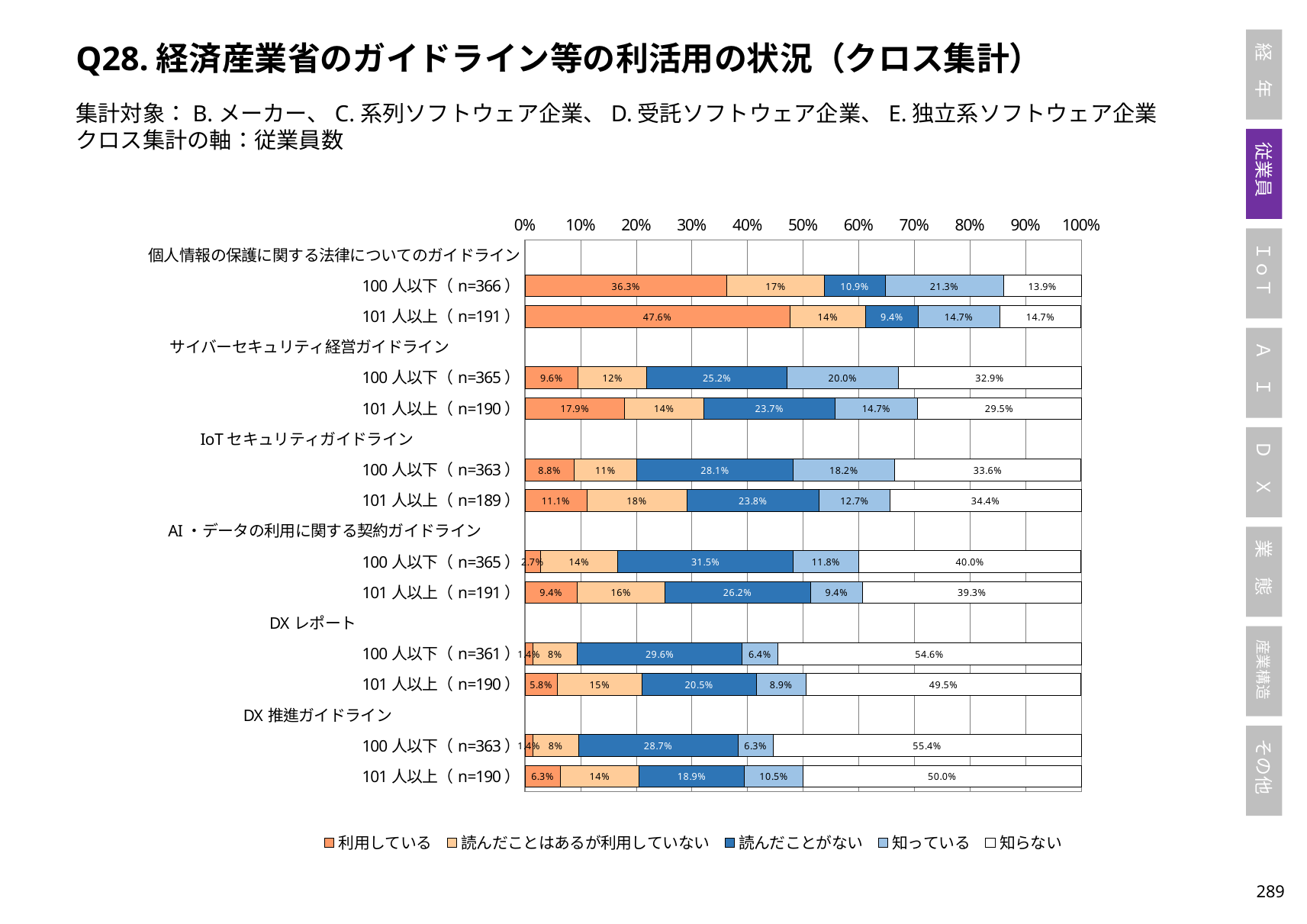
How many series does the chart legend list? 5 In the chart, what is the 読んだことがない value for 101人以上 (n=190) under DXレポート? 20.5% In the chart, what is the 利用している value for 101人以上 (n=191) under 個人情報の保護に関する法律についてのガイドライン? 47.6% What is the first entry in the chart legend? 利用している In the chart, what is the 利用している value for 100人以下 (n=366) under 個人情報の保護に関する法律についてのガイドライン? 36.3% In the chart, what is the 知らない value for 100人以下 (n=363) under DX推進ガイドライン? 55.4% In the chart, what is the 知らない value for 100人以下 (n=365) under AI・データの利用に関する契約ガイドライン? 40.0% Under サイバーセキュリティ経営ガイドライン, which group has the larger 利用している value, 100人以下 (n=365) or 101人以上 (n=190)? 101人以上 (n=190) In the chart, what is the 読んだことがない value for 101人以上 (n=189) under IoTセキュリティガイドライン? 23.8% Under 個人情報の保護に関する法律についてのガイドライン, what is the difference in the 利用している value between 101人以上 (n=191) and 100人以下 (n=366)? 11.3 percentage points Which row in the chart has the highest 知らない value? DX推進ガイドライン 100人以下 (n=363) What kind of chart is shown on the slide? Stacked bar chart